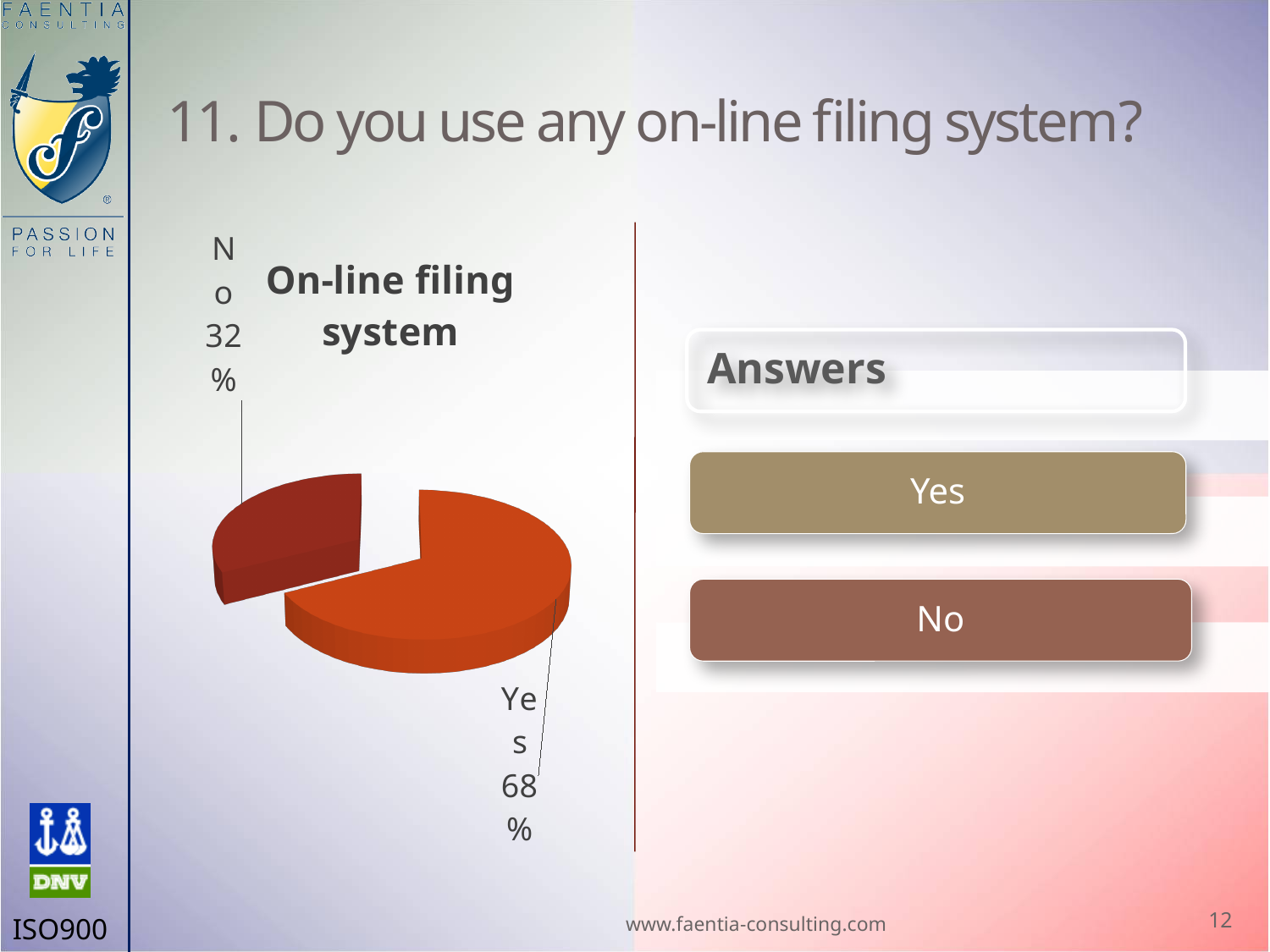
What is the title of the chart? On-line filing system How many slices does the pie chart have? 2 What colour is the Yes slice of the pie? orange-red What percentage of the pie is labelled No? 32% What share of the pie does the No slice represent? 32% What kind of chart is shown on the slide? pie chart Which slice of the pie is the largest? Yes What is the difference in percentage points between the Yes and No slices? 36 Which is larger, the Yes slice or the No slice? Yes What percentage of the pie is labelled Yes? 68% Which slice of the pie is the smallest? No